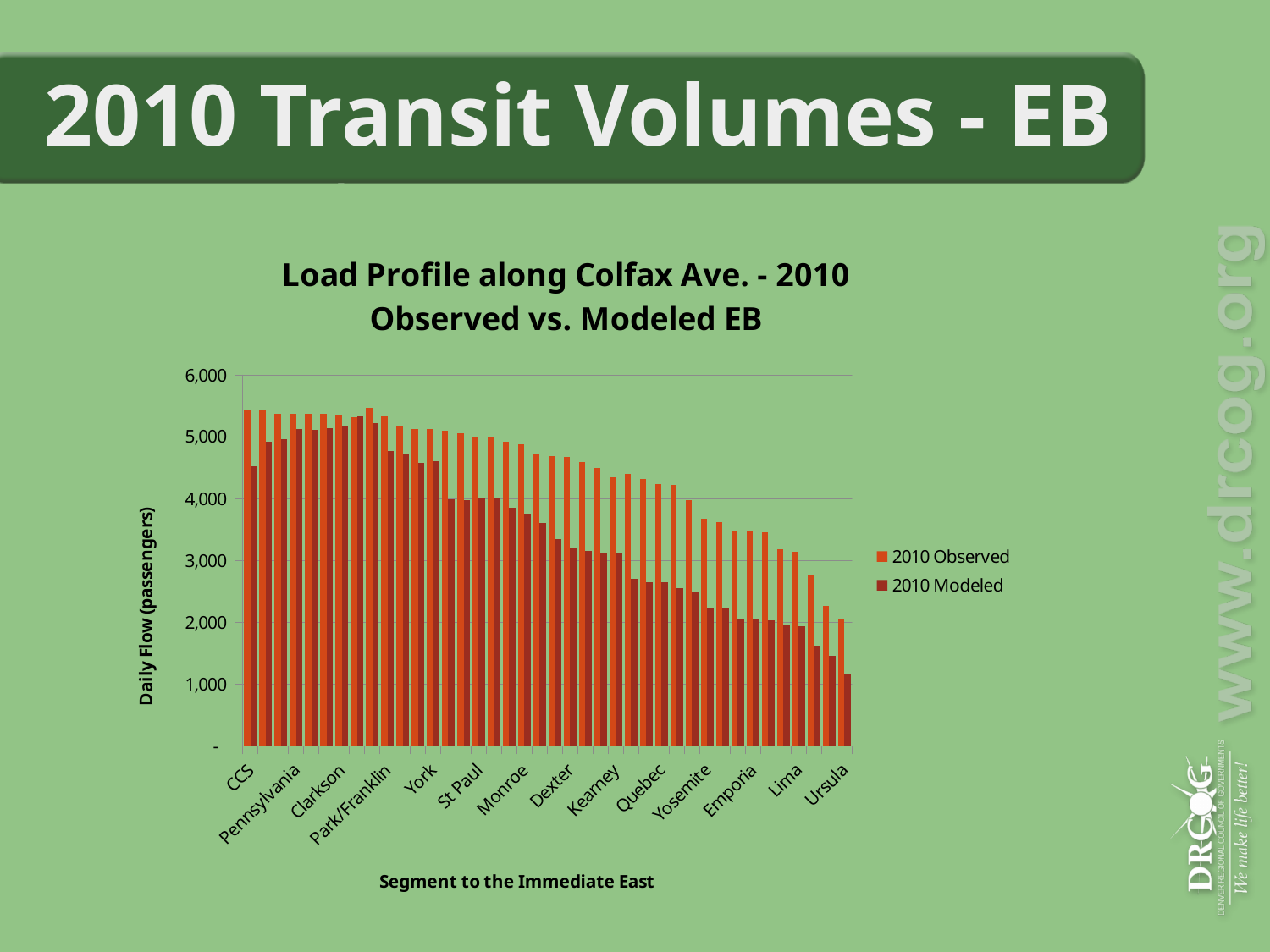
What are the two series named in the legend? 2010 Observed and 2010 Modeled What is the title of the chart? Load Profile along Colfax Ave. - 2010 Observed vs. Modeled EB Is the 2010 Modeled value for CCS greater or less than 5,000? less How many series does the legend list? 2 Which segment has the lowest 2010 Modeled value? Ursula Is the 2010 Observed value for Dexter greater or less than 4,000? greater Is the 2010 Observed value for CCS greater or less than 5,000? greater What kind of chart is shown on the slide? bar chart For Ursula, which is larger: the 2010 Observed value or the 2010 Modeled value? 2010 Observed Do the 2010 Observed values generally rise or fall moving from CCS to Ursula along the x axis? fall